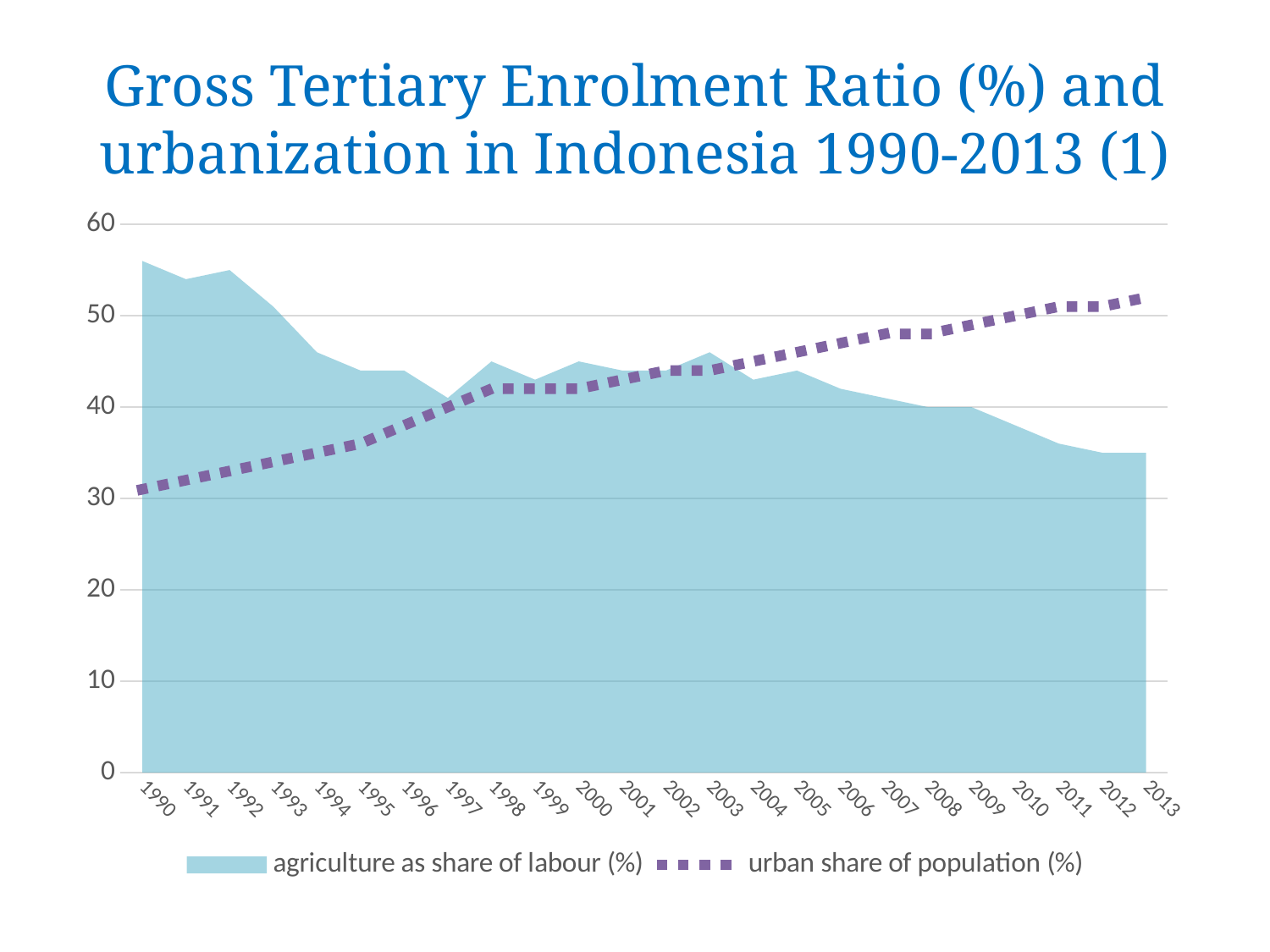
In 2013, which series has the larger value: agriculture as share of labour (%) or urban share of population (%)? urban share of population (%) In which year is agriculture as share of labour (%) highest? 1990 Is the value for urban share of population (%) in 1990 greater or less than 40? less Does the urban share of population (%) series rise or fall from 1990 to 2013? rise In which year is urban share of population (%) lowest? 1990 How many series does the legend list? 2 How many years are shown along the x axis? 24 Does the agriculture as share of labour (%) series rise or fall from 1990 to 2013? fall Is the value for agriculture as share of labour (%) in 1990 greater or less than 50? greater In 1990, which series has the larger value: agriculture as share of labour (%) or urban share of population (%)? agriculture as share of labour (%) What kind of chart is shown on the slide? area chart with a dotted line series Is the value for agriculture as share of labour (%) in 2013 greater or less than 40? less